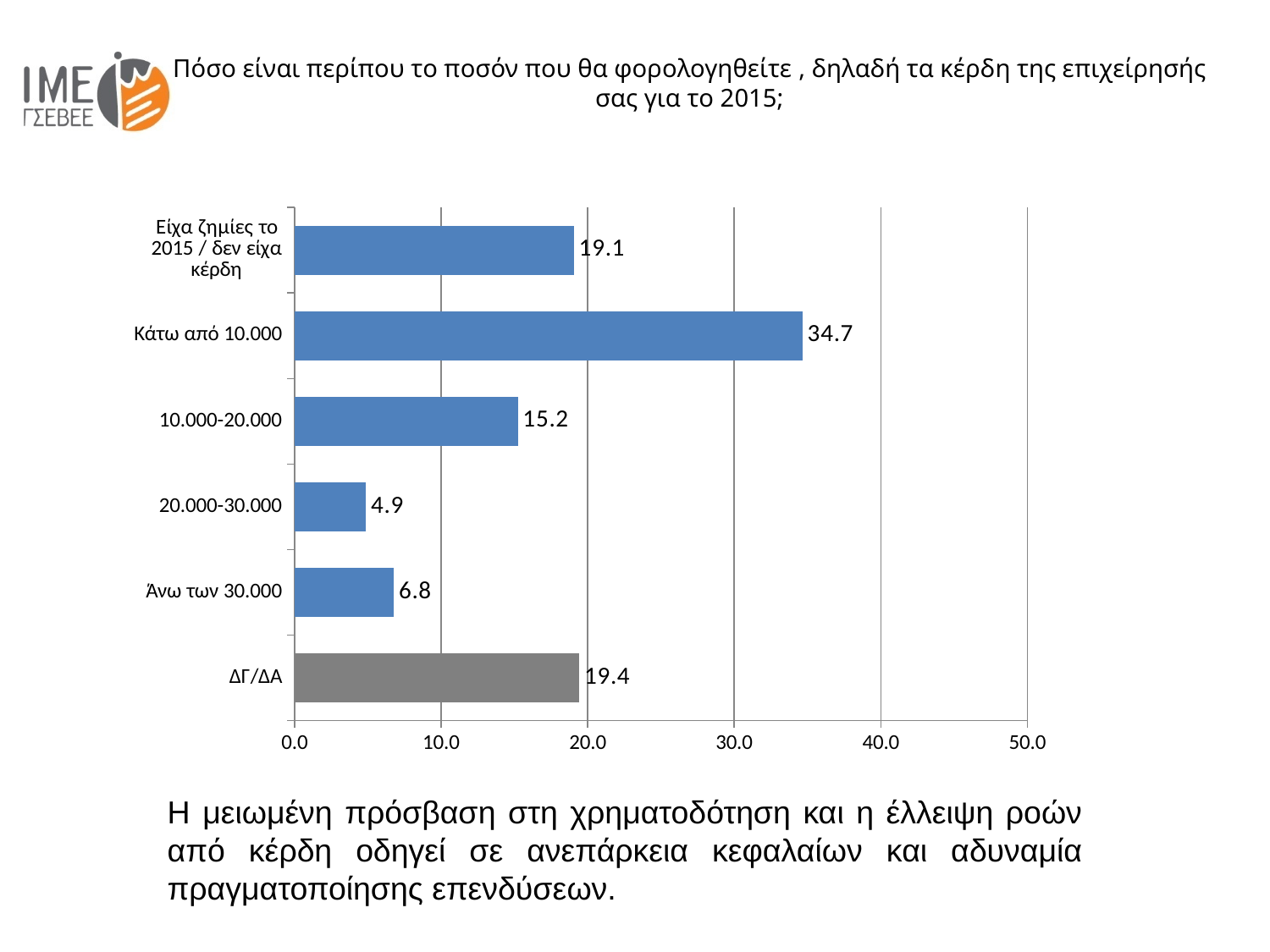
What is the value for the category "20.000-30.000"? 4.9 What is the value for the category "Κάτω από 10.000"? 34.7 Which category has the lowest value? 20.000-30.000 Which category has the highest value? Κάτω από 10.000 What is the difference between the values for "Κάτω από 10.000" and "10.000-20.000"? 19.5 What is the value for the category "ΔΓ/ΔΑ"? 19.4 How many categories are shown in the chart? 6 What kind of chart is shown on the slide? Bar chart Which is larger, the value for "Άνω των 30.000" or the value for "20.000-30.000"? Άνω των 30.000 What is the difference between the values for "ΔΓ/ΔΑ" and "Είχα ζημίες το 2015 / δεν είχα κέρδη"? 0.3 Is the value for "Κάτω από 10.000" greater or less than 30.0? greater Which bar is coloured differently (grey) from the others? ΔΓ/ΔΑ